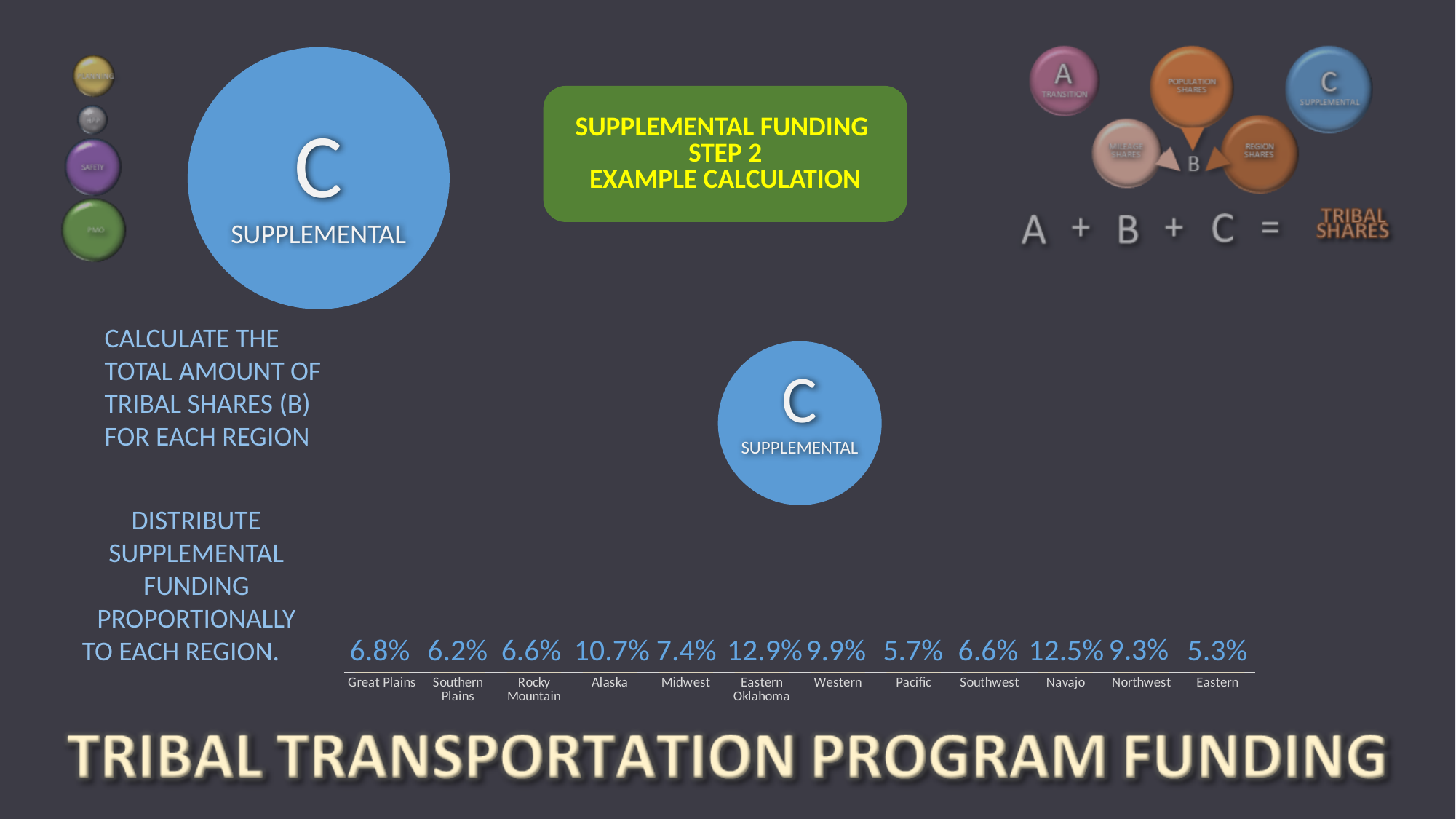
What is the difference between the values for Alaska and Great Plains? 3.9% Which region has the highest value? Eastern Oklahoma How many regions are shown in the chart? 12 Which is larger, the value for Midwest or the value for Southern Plains? Midwest What is the value shown for Pacific? 5.7% What is the value shown for Navajo? 12.5% What is the value shown for Eastern Oklahoma? 12.9% What is the difference between the values for Eastern Oklahoma and Navajo? 0.4% Which region has the lowest value? Eastern Which two regions share the same value of 6.6%? Rocky Mountain and Southwest Which is larger, the value for Western or the value for Northwest? Western What is the value shown for Alaska? 10.7%